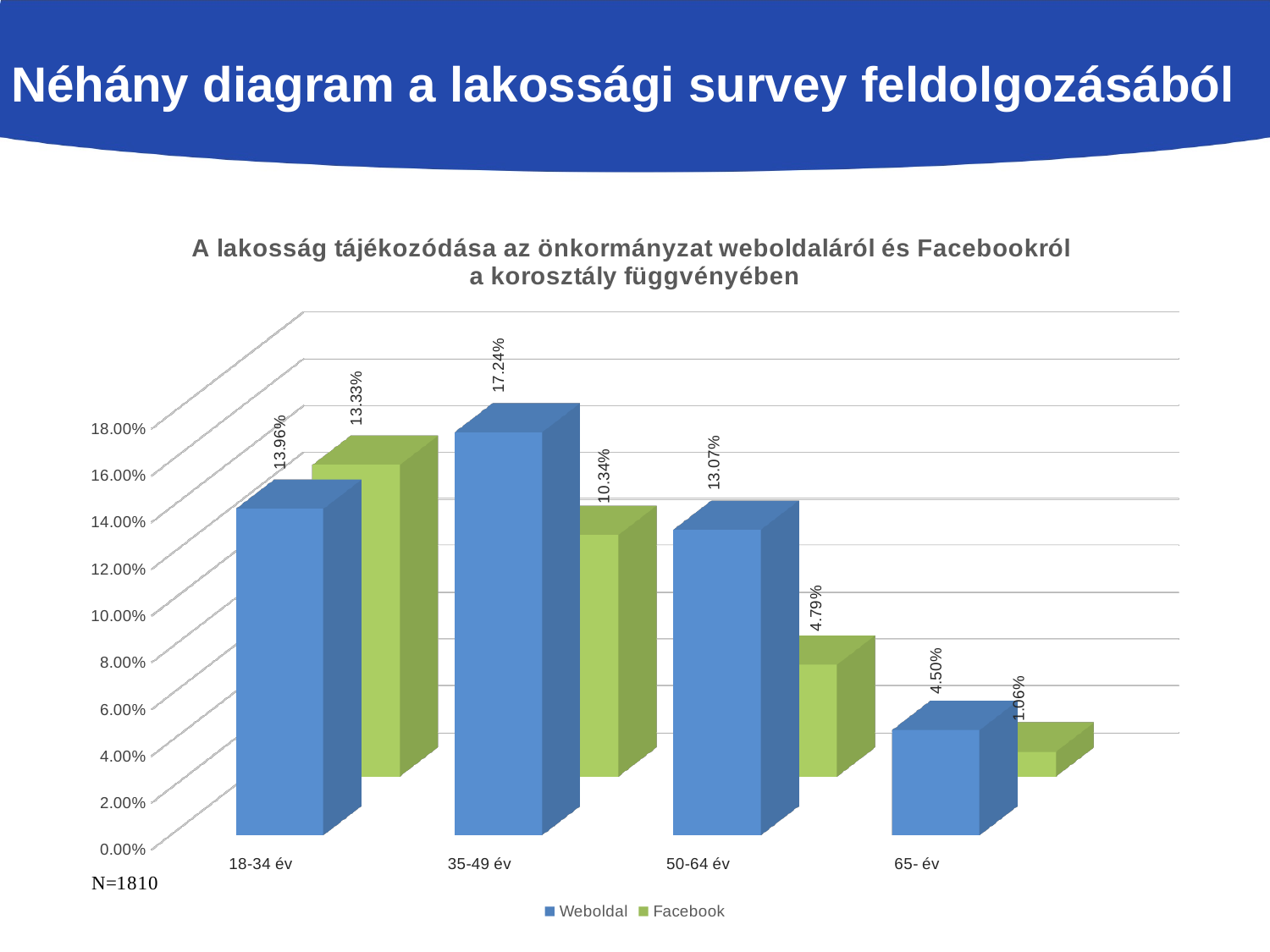
What sample size (N) is noted below the chart? N=1810 How many age groups are shown on the x axis? 4 Which age group has the lowest Facebook value? 65- év How many series does the legend list? 2 What is the Facebook value for the 18-34 év age group? 13.33% Do the Facebook values rise or fall from the 18-34 év group to the 65- év group? Fall What is the Facebook value for the 50-64 év age group? 4.79% What is the difference between the Weboldal and Facebook values for the 35-49 év age group? 6.90% Which is larger for the 50-64 év age group, Weboldal or Facebook? Weboldal What kind of chart is shown on the slide? Bar chart Which age group has the highest Weboldal value? 35-49 év What is the Weboldal value for the 35-49 év age group? 17.24%